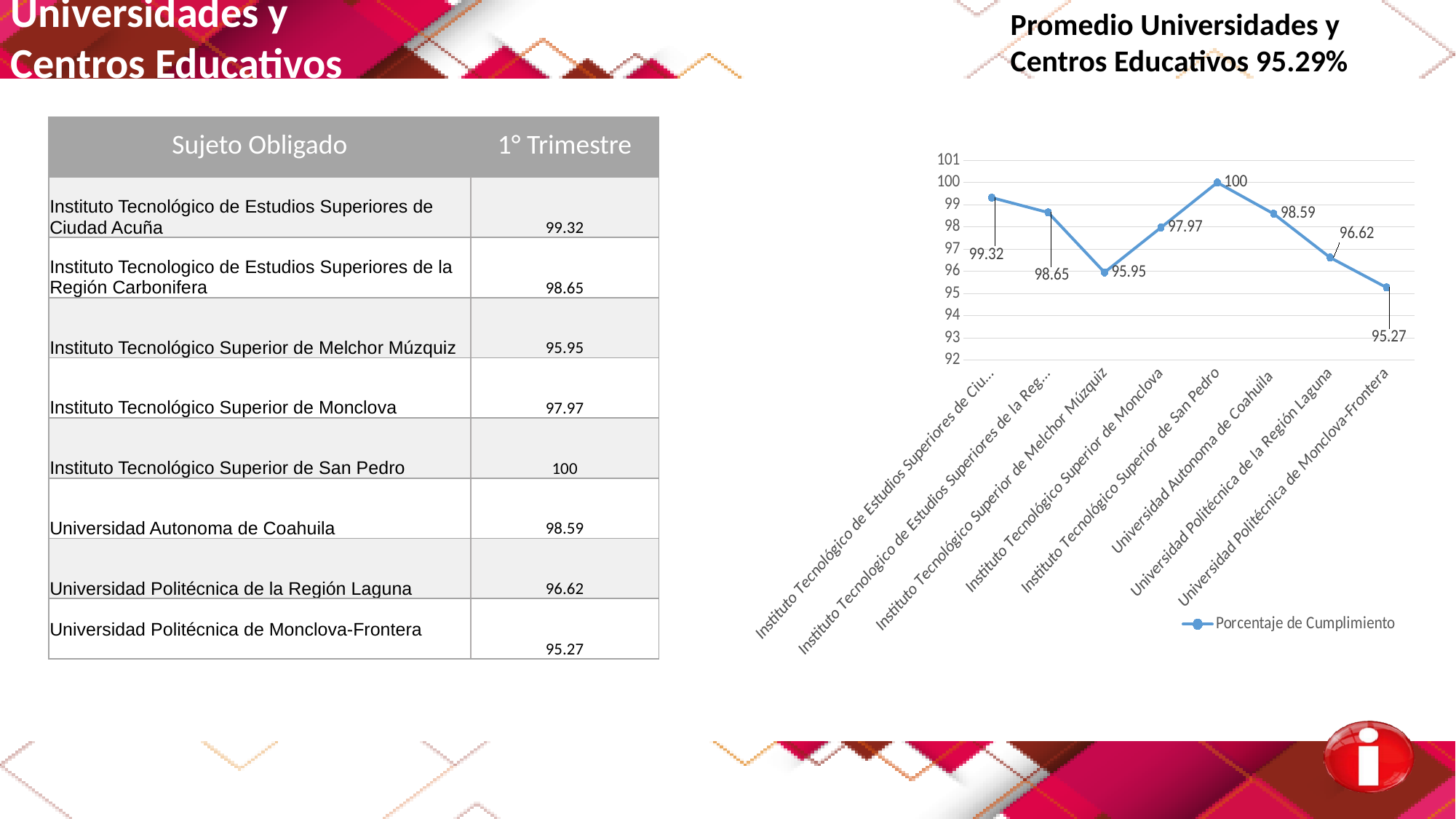
How many categories are plotted on the x axis? 8 Which category has the lowest value? Universidad Politécnica de Monclova-Frontera Which category has the highest value? Instituto Tecnológico Superior de San Pedro How many series does the legend list? 1 Which is larger, the value for Instituto Tecnológico Superior de Melchor Múzquiz or the value for Instituto Tecnológico Superior de Monclova? Instituto Tecnológico Superior de Monclova What is the value for Universidad Autonoma de Coahuila? 98.59 What is the difference between the values for Instituto Tecnológico Superior de San Pedro and Universidad Politécnica de Monclova-Frontera? 4.73 What is the value for Instituto Tecnológico Superior de San Pedro? 100 What is the name of the series shown in the legend? Porcentaje de Cumplimiento What type of chart is shown on the slide? line chart What is the value for Instituto Tecnológico Superior de Monclova? 97.97 What is the value for Universidad Politécnica de la Región Laguna? 96.62